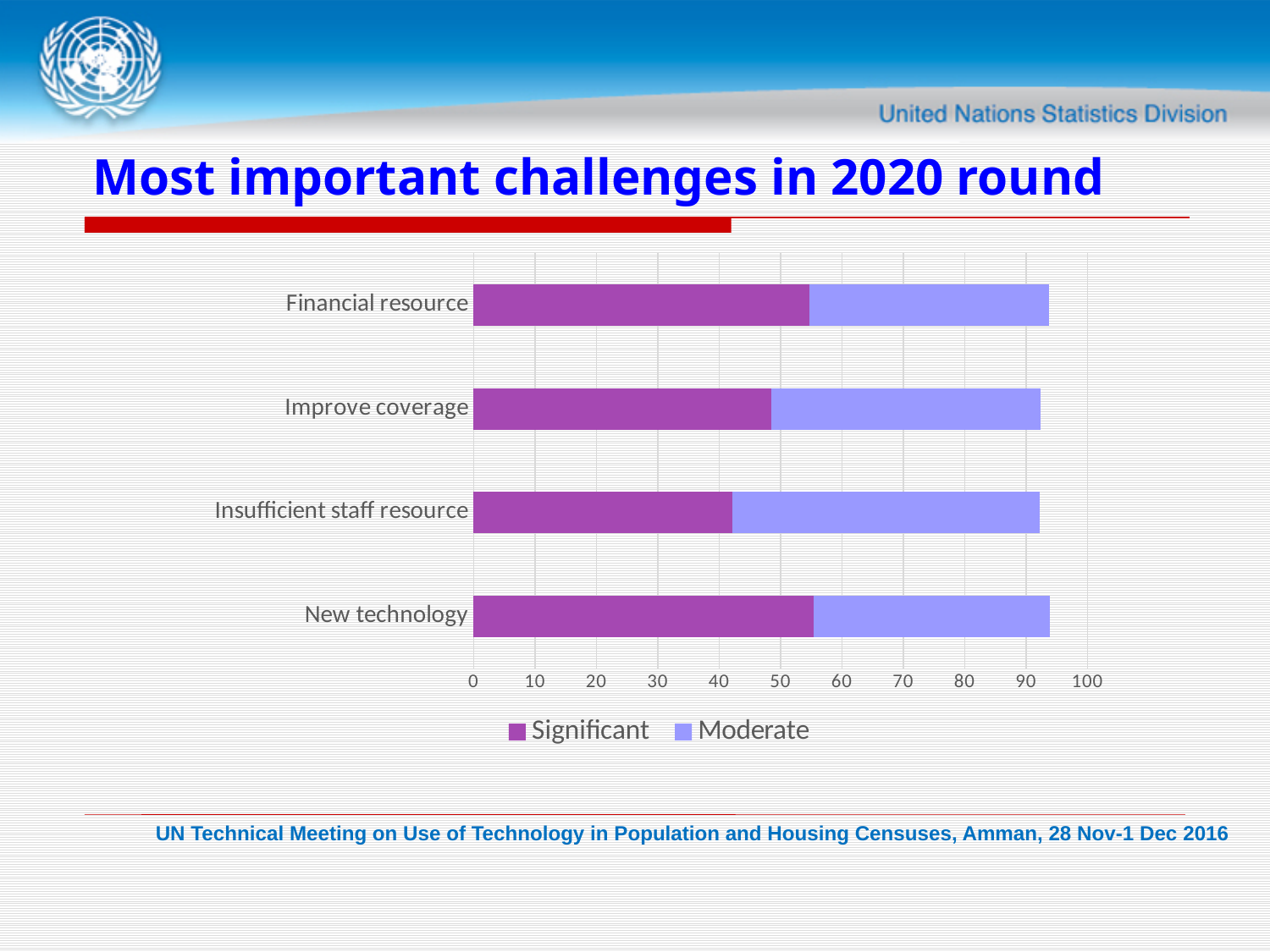
Is the Significant value for New technology greater or less than 50? greater Is the Significant value for Insufficient staff resource greater or less than 50? less Is the total length of the Financial resource bar greater or less than 90? greater How many series does the chart legend list? 2 What is the title of the slide containing the chart? Most important challenges in 2020 round Which has the larger Moderate value, Insufficient staff resource or Financial resource? Insufficient staff resource What are the two series named in the chart legend? Significant and Moderate Which has the larger Significant value, Financial resource or Insufficient staff resource? Financial resource How many challenge categories are plotted in the chart? 4 What kind of chart is shown on the slide? bar chart Which category has the lowest value for the Significant series? Insufficient staff resource